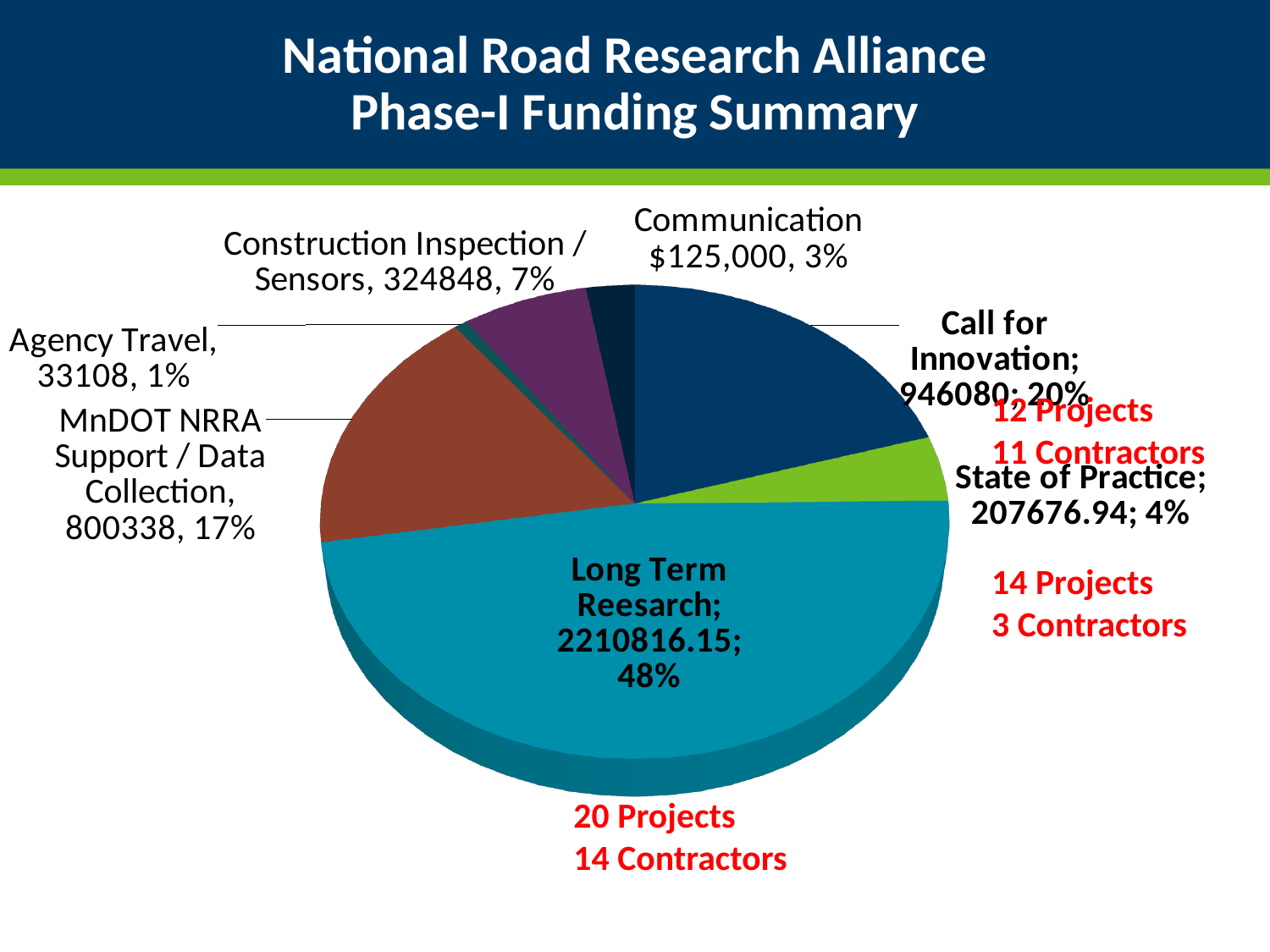
Which is larger, the share for Construction Inspection / Sensors or the share for State of Practice? Construction Inspection / Sensors Which category has the largest slice of the pie? Long Term Reesarch What share of the pie does MnDOT NRRA Support / Data Collection represent? 17% What is the funding value shown for State of Practice? 207676.94 What kind of chart is shown on the slide? Pie chart What share of the pie does Long Term Reesarch represent? 48% What is the title of the slide containing the pie chart? National Road Research Alliance Phase-I Funding Summary What is the difference in percentage points between the Call for Innovation share and the MnDOT NRRA Support / Data Collection share? 3 percentage points How many slices does the pie chart have? 7 Which category has the smallest slice of the pie? Agency Travel What is the funding value shown for Communication? $125,000 What is the funding value shown for Call for Innovation? 946080